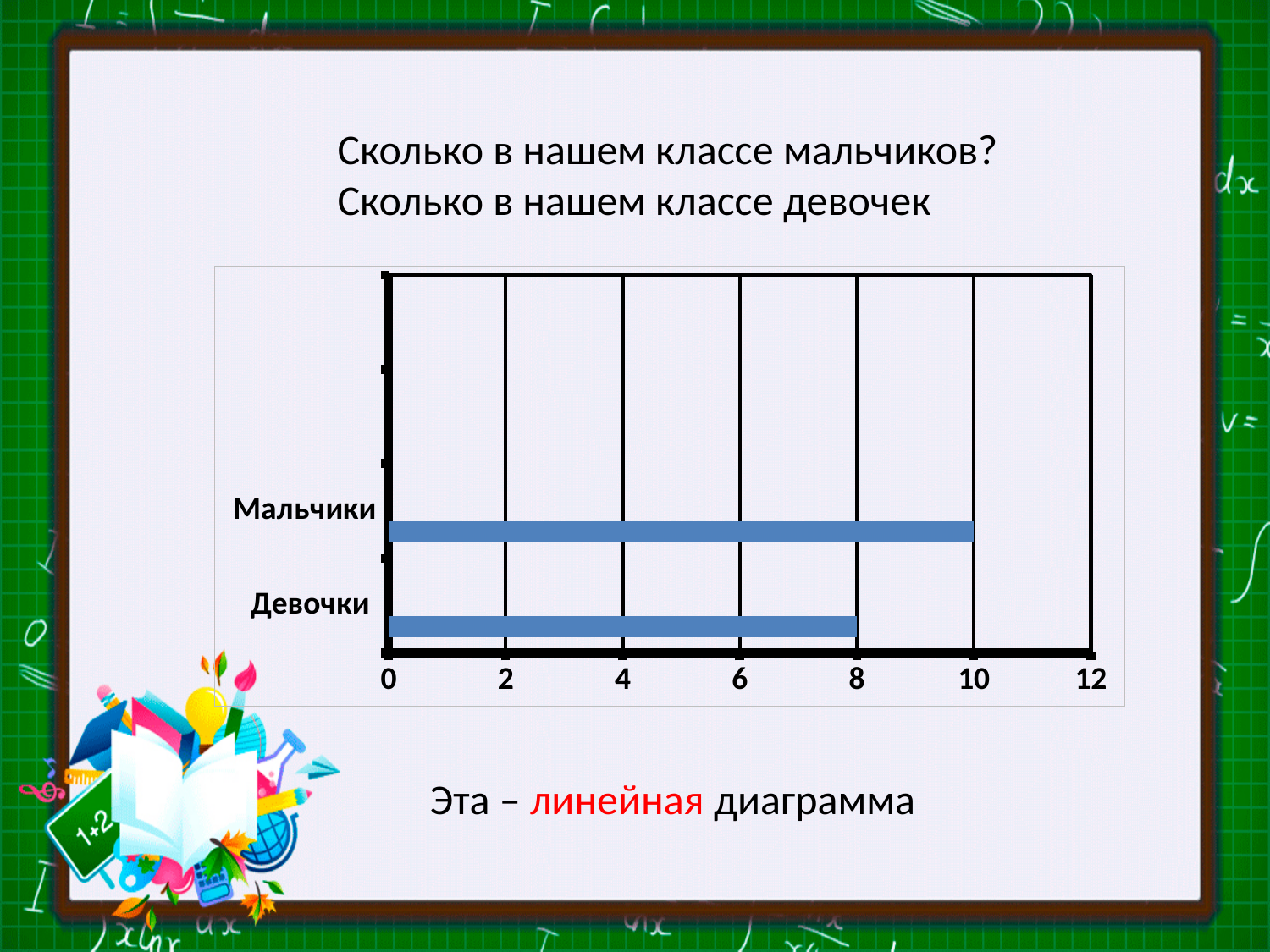
What is the value for Девочки? 8 Which is larger, the value for Мальчики or the value for Девочки? Мальчики What is the difference between the values for Мальчики and Девочки? 2 What is the value for Мальчики? 10 How many categories are shown in the chart? 2 What is the maximum value shown on the horizontal axis? 12 What kind of chart is shown on the slide? bar chart Which category has the highest value? Мальчики Which category has the lowest value? Девочки Is the value for Мальчики greater or less than 6? greater What colour are the bars in the chart? blue Is the value for Девочки greater or less than 10? less